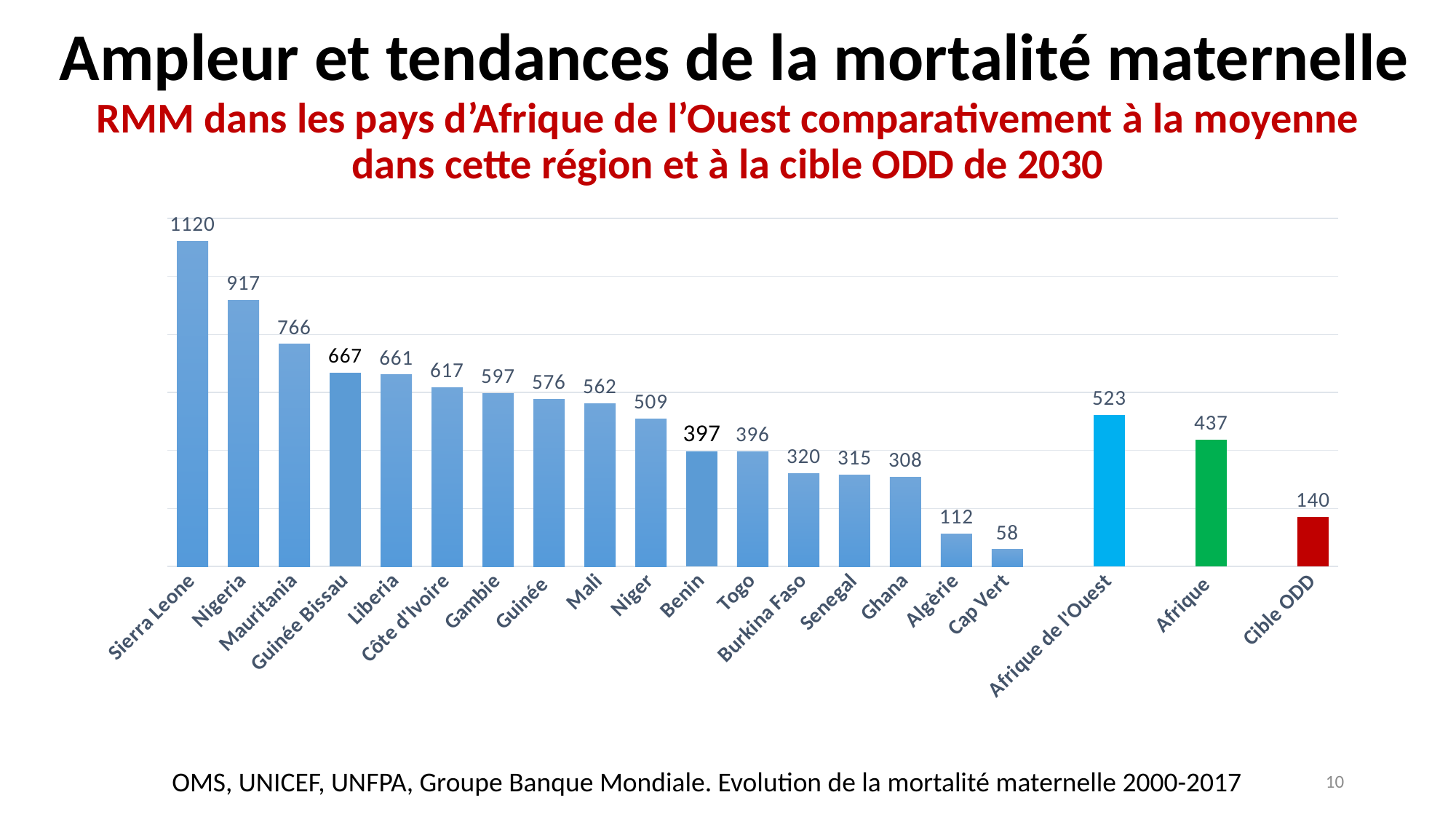
What is the difference between the values for Afrique de l'Ouest and Afrique? 86 What is the value for Sierra Leone? 1120 What colour is the bar for Afrique? Green What kind of chart is shown on the slide? Bar chart What is the value for Burkina Faso? 320 What is the value for Cible ODD? 140 What is the value for Afrique de l'Ouest? 523 Which is larger, the value for Mali or the value for Niger? Mali Which category has the lowest value? Cap Vert What is the difference between the values for Nigeria and Mauritania? 151 Which category has the highest value? Sierra Leone How many bars are plotted in the chart? 20